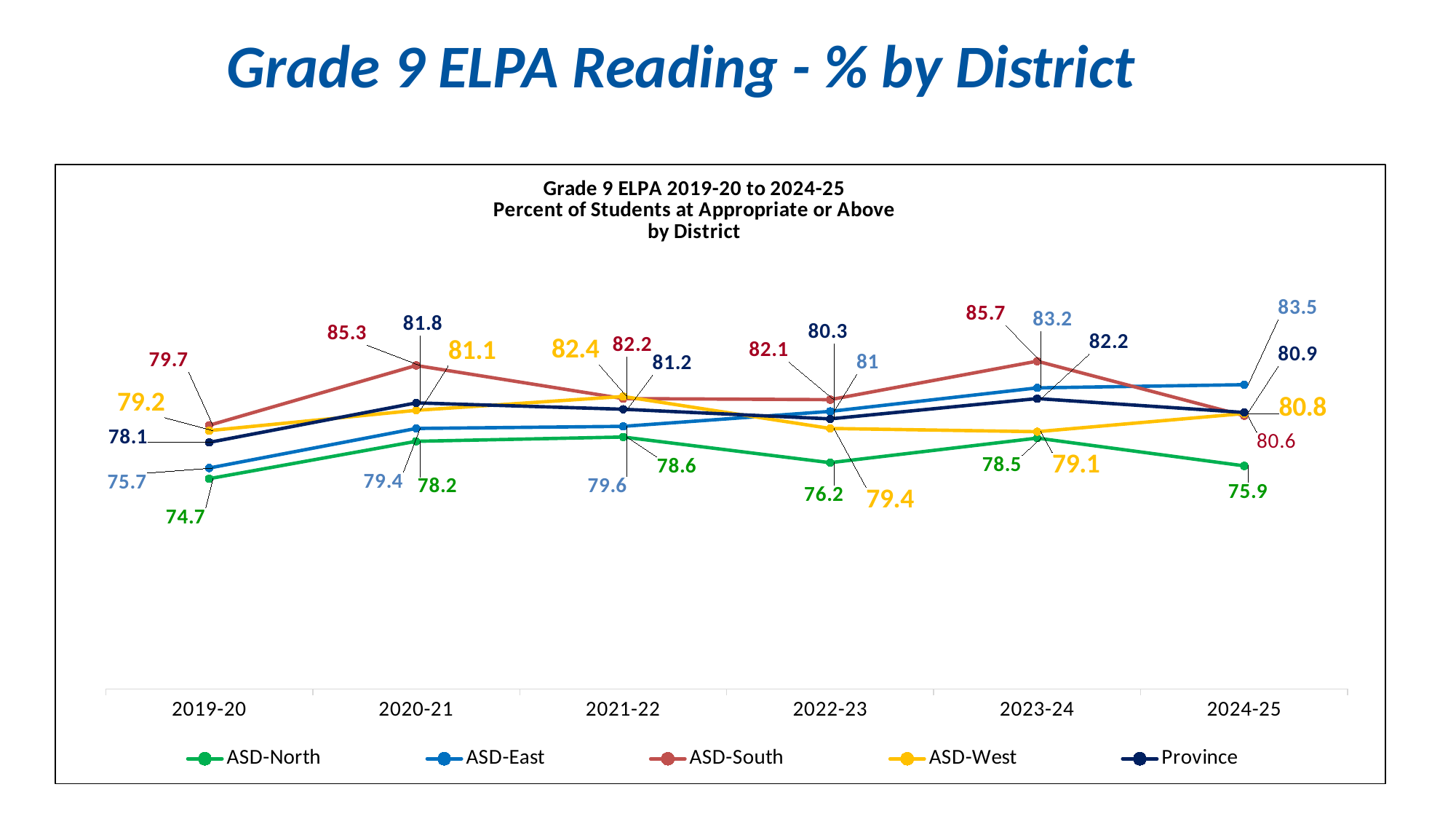
What is the difference between ASD-South and ASD-North in 2020-21? 7.1 What is the value for Province in 2022-23? 80.3 Which series has the lowest value in 2024-25? ASD-North What type of chart is shown on the slide? Line chart Does the ASD-North line rise or fall from 2023-24 to 2024-25? Fall What is the value for ASD-East in 2024-25? 83.5 How many school years are plotted along the x axis? 6 How many series does the legend list? 5 Which district has the highest value in 2023-24? ASD-South What is the value for ASD-South in 2020-21? 85.3 What is the value for ASD-North in 2019-20? 74.7 Which is larger in 2021-22, ASD-West or ASD-East? ASD-West